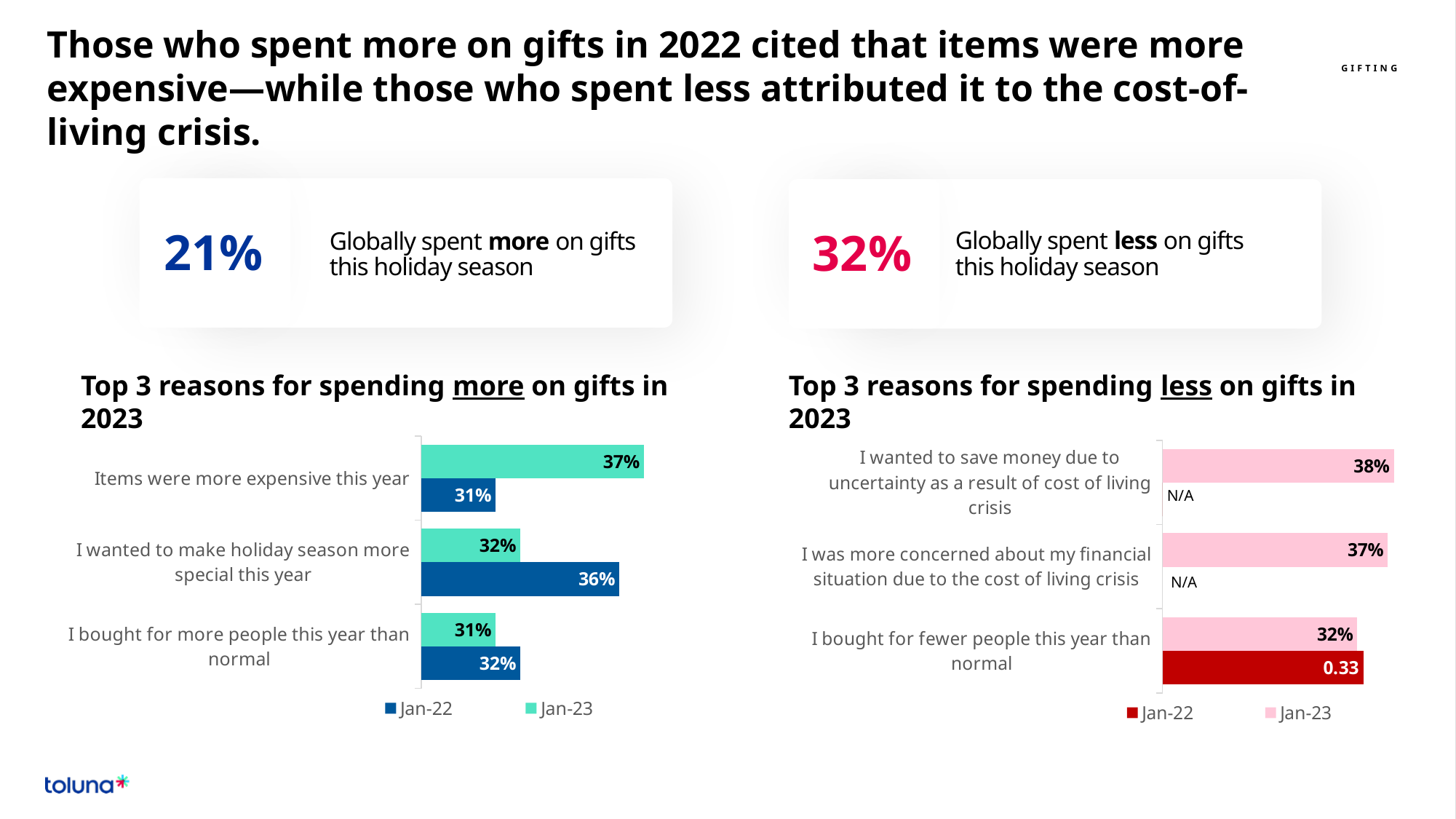
In the chart 'Top 3 reasons for spending more on gifts in 2023', what is the Jan-23 value for 'I bought for more people this year than normal'? 31% In the chart 'Top 3 reasons for spending more on gifts in 2023', what is the Jan-23 value for 'Items were more expensive this year'? 37% In the chart 'Top 3 reasons for spending more on gifts in 2023', what is the difference between the Jan-23 and Jan-22 values for 'Items were more expensive this year'? 6% In the chart 'Top 3 reasons for spending less on gifts in 2023', which reason has the lowest Jan-23 value? I bought for fewer people this year than normal In the chart 'Top 3 reasons for spending less on gifts in 2023', what is shown as the Jan-22 value for 'I was more concerned about my financial situation due to the cost of living crisis'? N/A In the chart 'Top 3 reasons for spending more on gifts in 2023', for 'I wanted to make holiday season more special this year', which is larger: the Jan-22 or the Jan-23 value? Jan-22 In the chart 'Top 3 reasons for spending less on gifts in 2023', what is the Jan-22 value shown for 'I bought for fewer people this year than normal'? 0.33 What kind of chart is 'Top 3 reasons for spending more on gifts in 2023'? Bar chart In the chart 'Top 3 reasons for spending more on gifts in 2023', which reason has the highest Jan-23 value? Items were more expensive this year In the chart 'Top 3 reasons for spending more on gifts in 2023', what is the Jan-22 value for 'I wanted to make holiday season more special this year'? 36% How many series does the legend list in the chart 'Top 3 reasons for spending less on gifts in 2023'? 2 In the chart 'Top 3 reasons for spending less on gifts in 2023', what is the Jan-23 value for 'I wanted to save money due to uncertainty as a result of cost of living crisis'? 38%